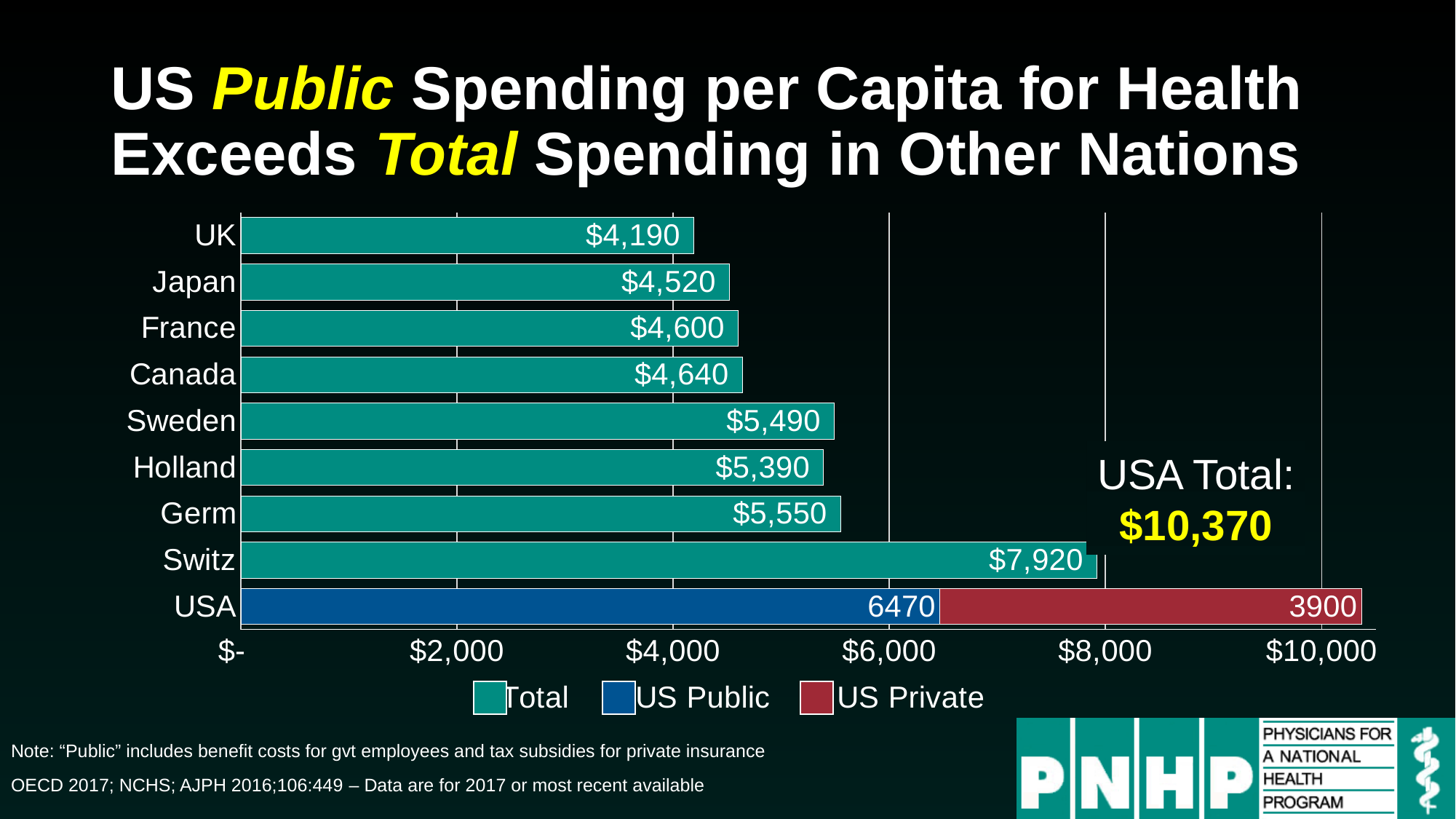
Which has a larger Total spending per capita, Sweden or Canada? Sweden How many series does the legend list? 3 What is the US Private spending per capita value shown for the USA? 3900 Among the countries with a Total bar, which has the highest Total spending per capita? Switz What is the Total spending per capita for the UK? $4,190 What is the Total spending per capita for Switz? $7,920 What is the total of the stacked USA bar (US Public plus US Private)? $10,370 Which country has the lowest Total spending per capita? UK How many countries are listed on the y axis? 9 What kind of chart is shown on the slide? Bar chart What is the difference between the Total spending for Germ and Holland? $160 What is the US Public spending per capita value shown for the USA? 6470